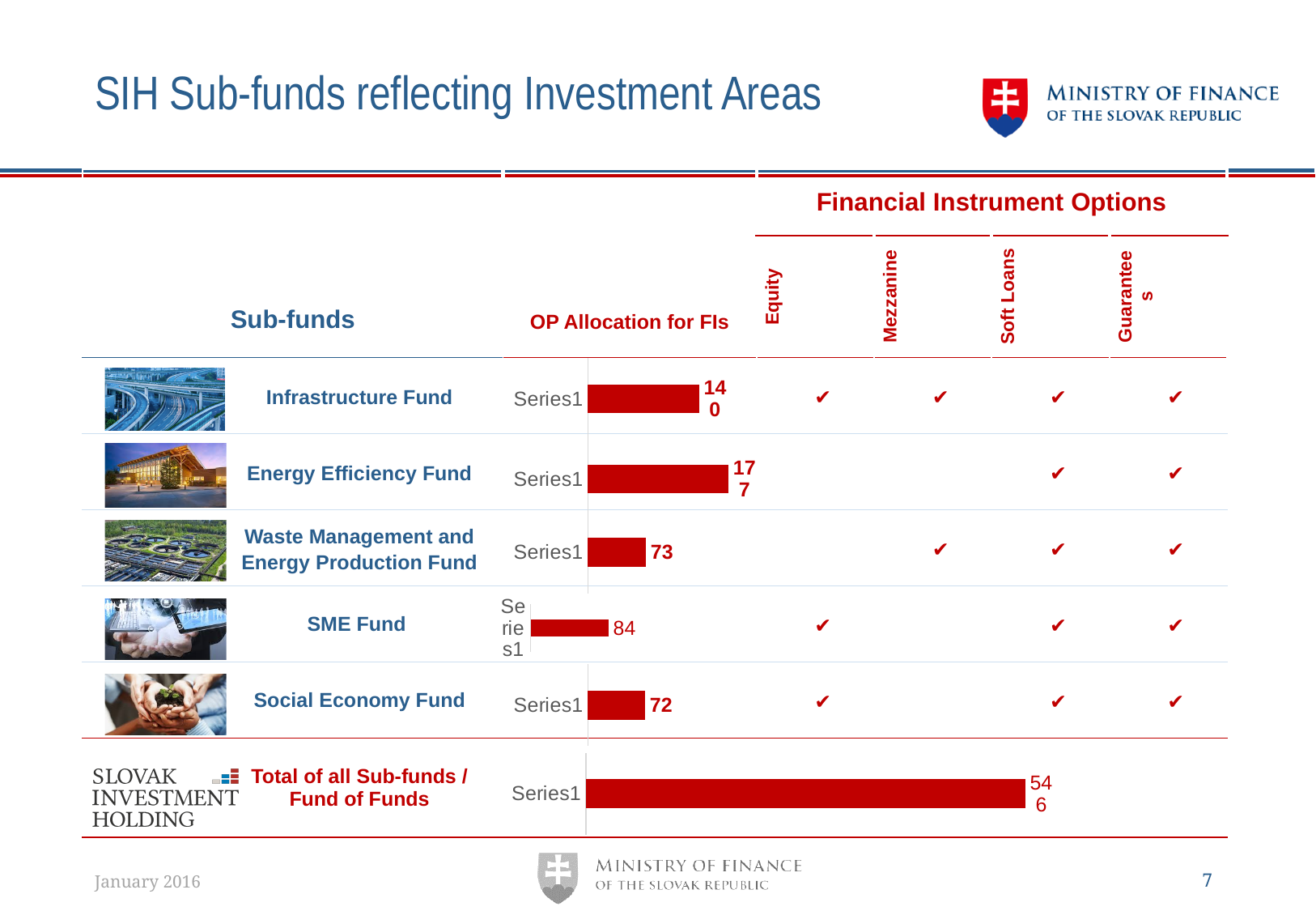
Which is larger: the OP Allocation for FIs value in the SME Fund row or the value in the Waste Management and Energy Production Fund row? SME Fund In the OP Allocation for FIs chart in the Energy Efficiency Fund row, what value is shown on the bar? 177 In the OP Allocation for FIs chart in the Social Economy Fund row, what label appears on the axis next to the bar? Series1 In the OP Allocation for FIs chart in the Social Economy Fund row, what value is shown on the bar? 72 In the OP Allocation for FIs chart in the Total of all Sub-funds / Fund of Funds row, what value is shown on the bar? 546 Across the OP Allocation for FIs charts for the five individual sub-funds, which sub-fund has the lowest value? Social Economy Fund What is the difference between the OP Allocation for FIs value in the Energy Efficiency Fund row and the value in the Infrastructure Fund row? 37 In the OP Allocation for FIs chart in the Infrastructure Fund row, what value is shown on the bar? 140 In the OP Allocation for FIs chart in the SME Fund row, what value is shown on the bar? 84 What kind of chart is used in the OP Allocation for FIs column of the Infrastructure Fund row? bar chart Across the OP Allocation for FIs charts for the five individual sub-funds, which sub-fund has the highest value? Energy Efficiency Fund In the OP Allocation for FIs chart in the Waste Management and Energy Production Fund row, what value is shown on the bar? 73